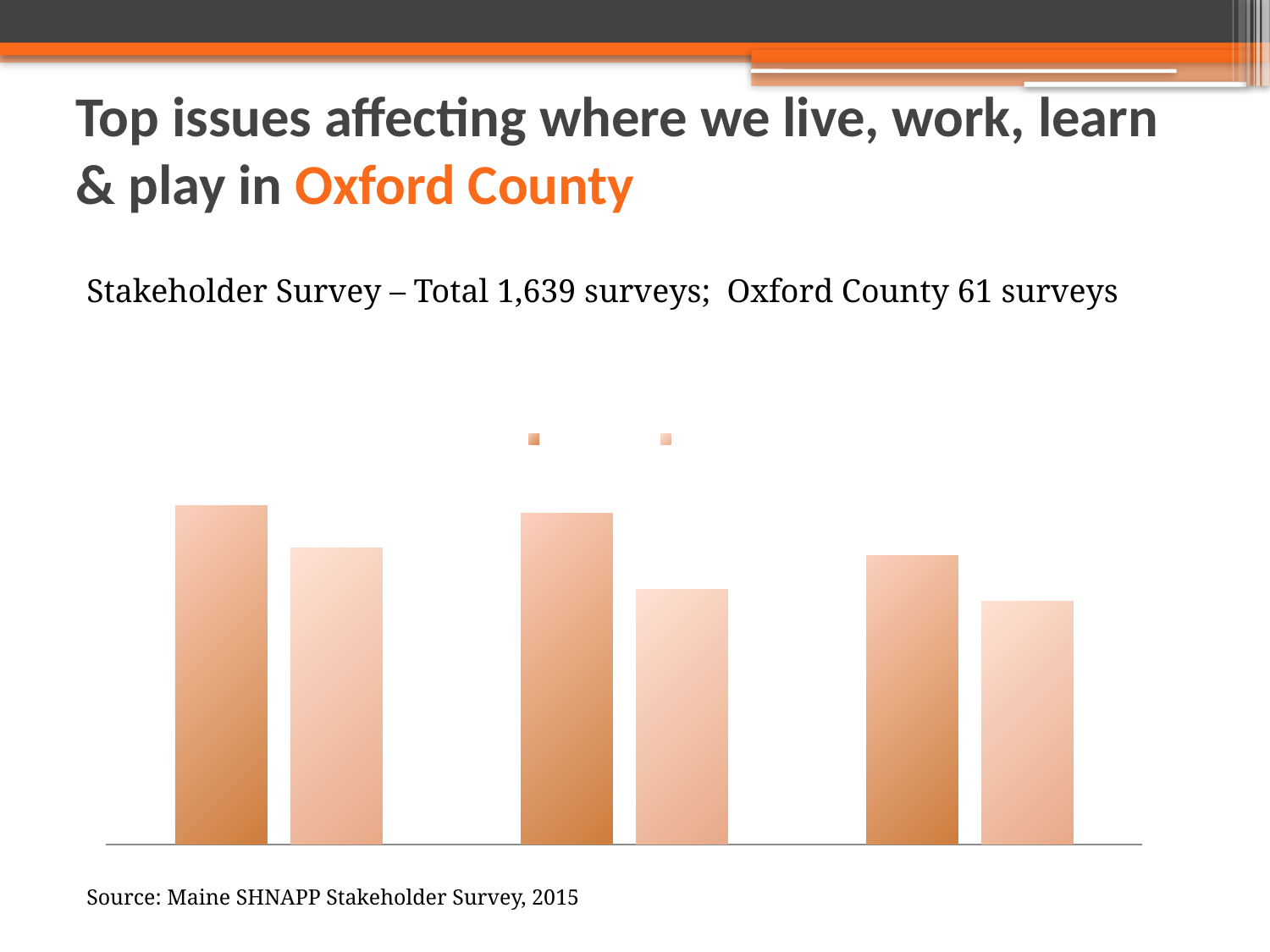
Is the darker bar in the middle group taller or shorter than the darker bar in the leftmost group? shorter Which group of bars, by position, contains the tallest bar on the chart? the leftmost group How many groups of bars (categories) does the chart show? 3 Do the darker orange bars rise or fall from left to right across the chart? fall What colour family are the bars on the chart? orange How many series does the chart's legend list? 2 In the rightmost group of bars, which is taller: the darker bar or the lighter bar? the darker bar Which group of bars, by position, contains the shortest bar on the chart? the rightmost group Do the lighter orange bars rise or fall from left to right across the chart? fall In the leftmost group of bars, which is taller: the darker bar or the lighter bar? the darker bar How many bars are plotted in total on the chart? 6 What kind of chart is shown on the slide? bar chart